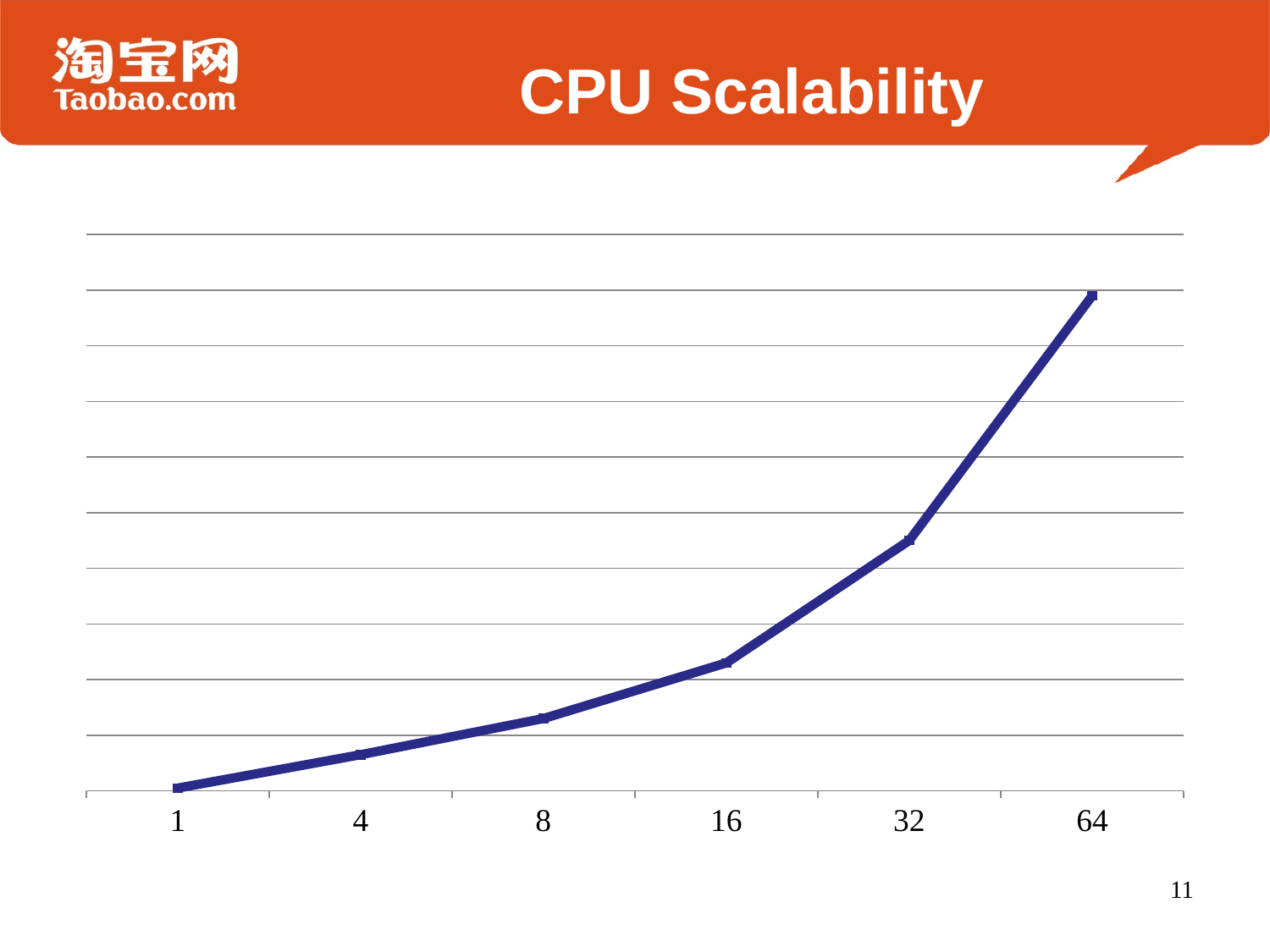
How many points are plotted on the line in the CPU Scalability chart? 6 Do the values rise or fall as you move from 1 to 64 along the x axis? rise Which has the larger value in the CPU Scalability chart, 4 or 8? 8 Which has the larger value in the CPU Scalability chart, 32 or 16? 32 Which has the larger value in the CPU Scalability chart, 64 or 32? 64 What is the title of the chart on the slide? CPU Scalability What is the first category label on the x axis of the CPU Scalability chart? 1 Which x-axis category has the highest value in the CPU Scalability chart? 64 What kind of chart is shown on the slide? line chart How many series are plotted in the CPU Scalability chart? 1 Which x-axis category has the lowest value in the CPU Scalability chart? 1